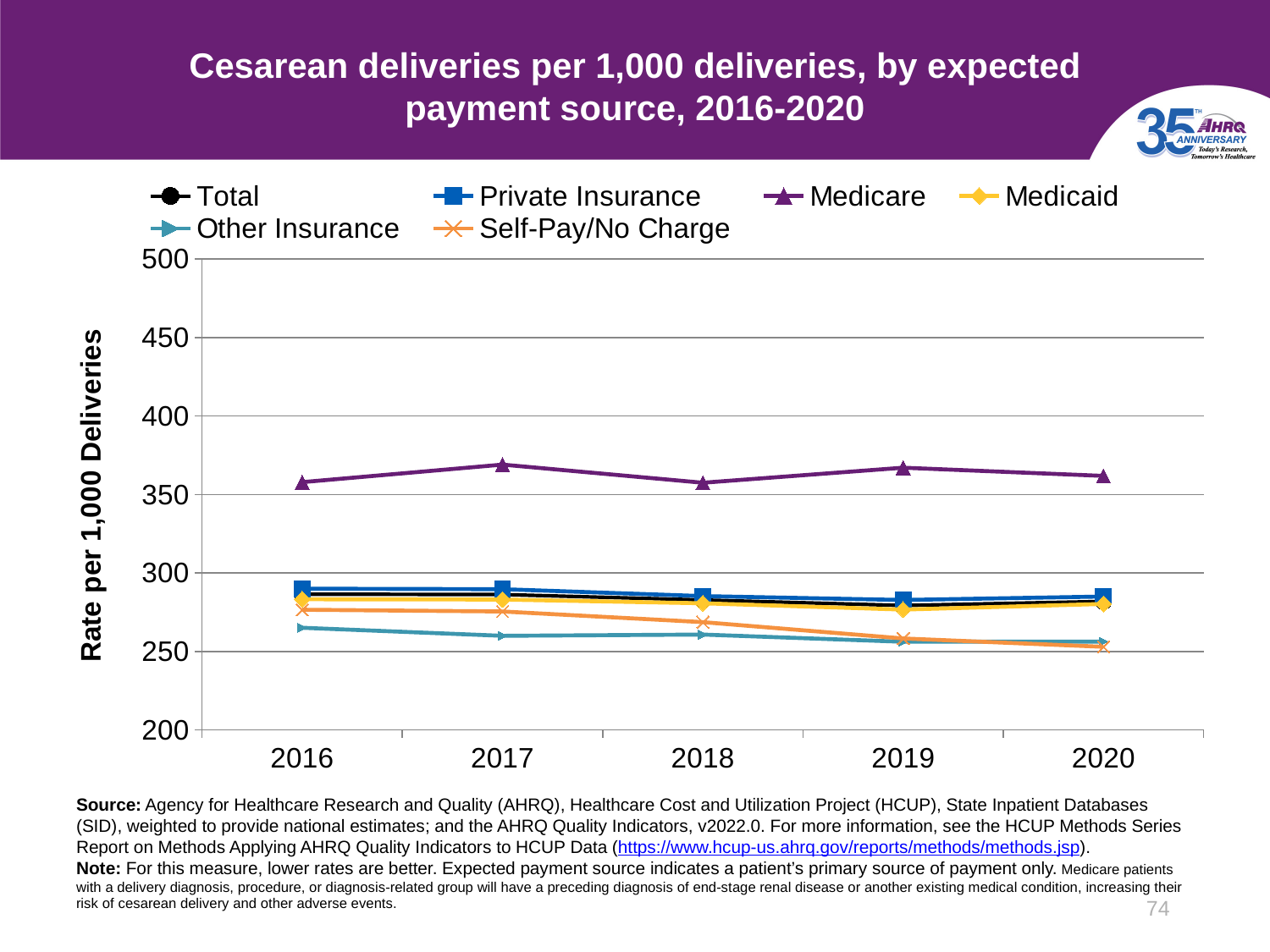
What kind of chart is shown on the slide? Line chart Which payment source has the lowest rate in 2016? Other Insurance How many series does the legend list? 6 Which is larger, the Medicare value for 2017 or for 2018? 2017 Is the Medicare value for 2017 greater or less than 350? greater Is the Medicare value for 2019 greater or less than 400? less How many years are plotted along the x axis? 5 Which payment source has the highest cesarean delivery rate in every year shown? Medicare Does the Self-Pay/No Charge rate rise or fall from 2016 to 2020? Fall In 2016, which is larger, the Private Insurance value or the Other Insurance value? Private Insurance Is the Self-Pay/No Charge value for 2020 greater or less than 300? less What is the label on the y axis? Rate per 1,000 Deliveries